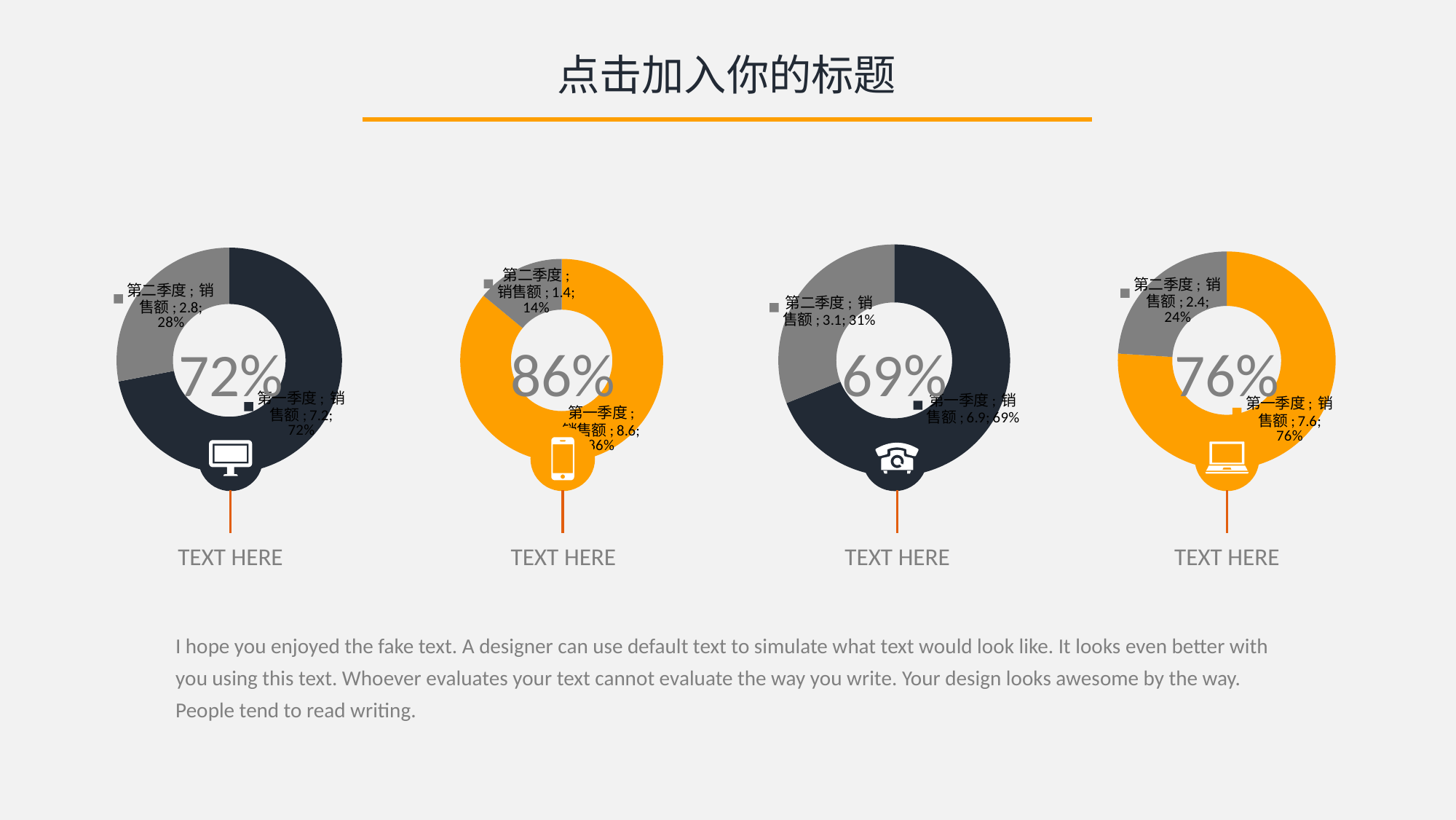
In the rightmost donut chart, which slice is larger, 第一季度 or 第二季度? 第一季度 In the third donut chart from the left, what share of the donut does 第二季度 take? 31% In the leftmost donut chart, what is the difference between the 第一季度 and 第二季度 销售额 values? 4.4 What kind of chart is the second chart from the left? Donut chart In the third donut chart from the left, what is the 销售额 value for 第一季度? 6.9 How many slices does the third donut chart from the left have? 2 In the leftmost donut chart, what share of the donut does 第二季度 take? 28% In the leftmost donut chart, what is the 销售额 value for 第一季度? 7.2 In the second donut chart from the left, what share of the donut does 第一季度 take? 86% In the second donut chart from the left, what is the 销售额 value for 第二季度? 1.4 What large percentage is printed in the centre of the rightmost donut chart? 76% In the rightmost donut chart, what is the 销售额 value for 第二季度? 2.4